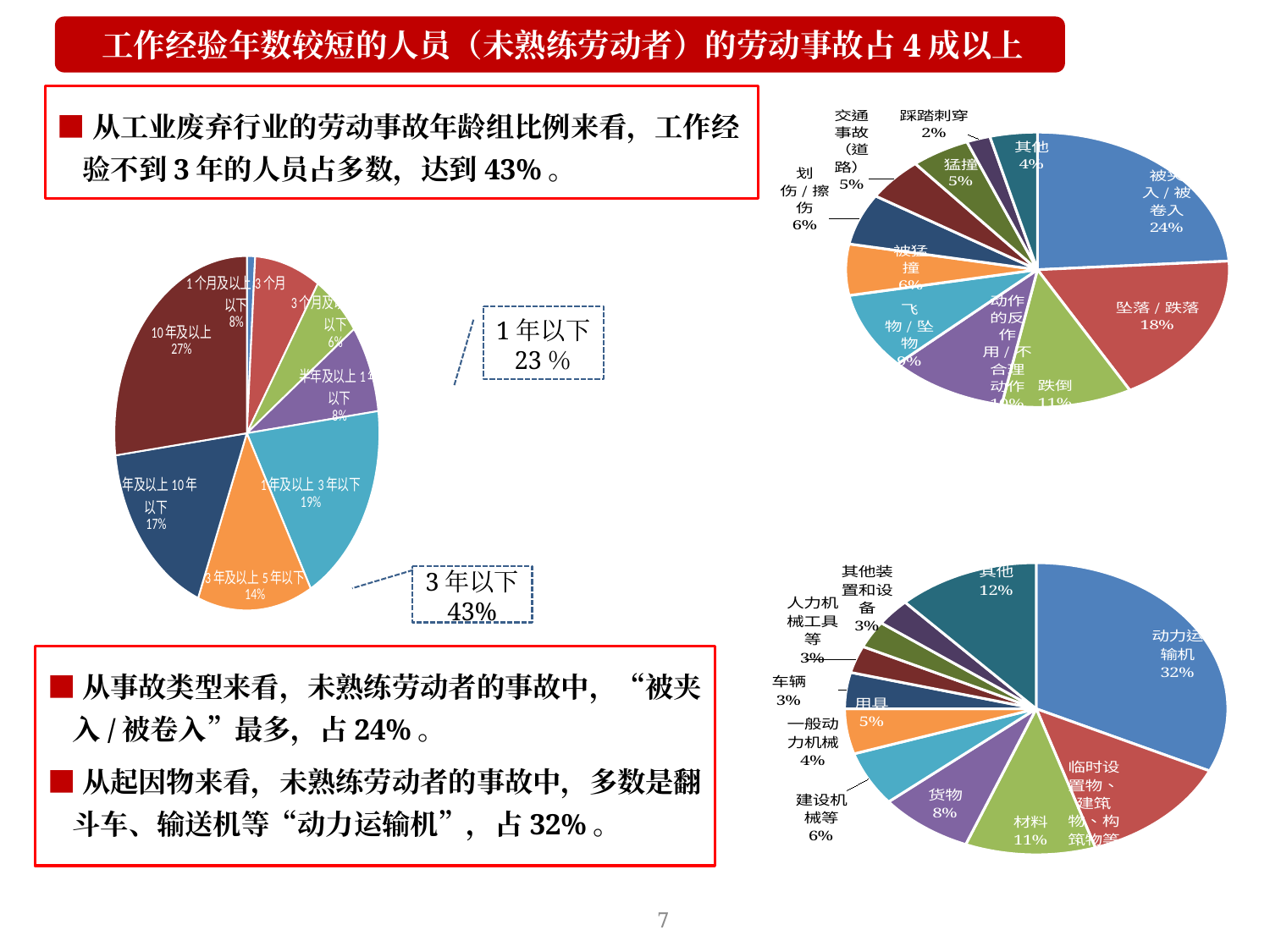
In the pie chart at the bottom right of the slide, what share is labelled for 材料? 11% In the pie chart at the top right of the slide, which category has the smallest share? 踩踏刺穿 What type of chart is used on the left of the slide? Pie chart In the pie chart at the bottom right of the slide, what share is labelled for 其他? 12% In the pie chart at the bottom right of the slide, which is larger, the share for 货物 or the share for 建设机械等? 货物 In the pie chart on the left of the slide, what share is labelled for 10年及以上? 27% In the pie chart at the top right of the slide, what share is labelled for 被夹入/被卷入? 24% In the pie chart at the top right of the slide, what is the difference between the shares for 被夹入/被卷入 and 坠落/跌落? 6% In the pie chart at the top right of the slide, what share is labelled for 坠落/跌落? 18% In the pie chart at the bottom right of the slide, what share is labelled for 动力运输机? 32% In the pie chart on the left of the slide, what share is labelled for 1年及以上3年以下? 19% In the pie chart at the top right of the slide, which category has the largest share? 被夹入/被卷入